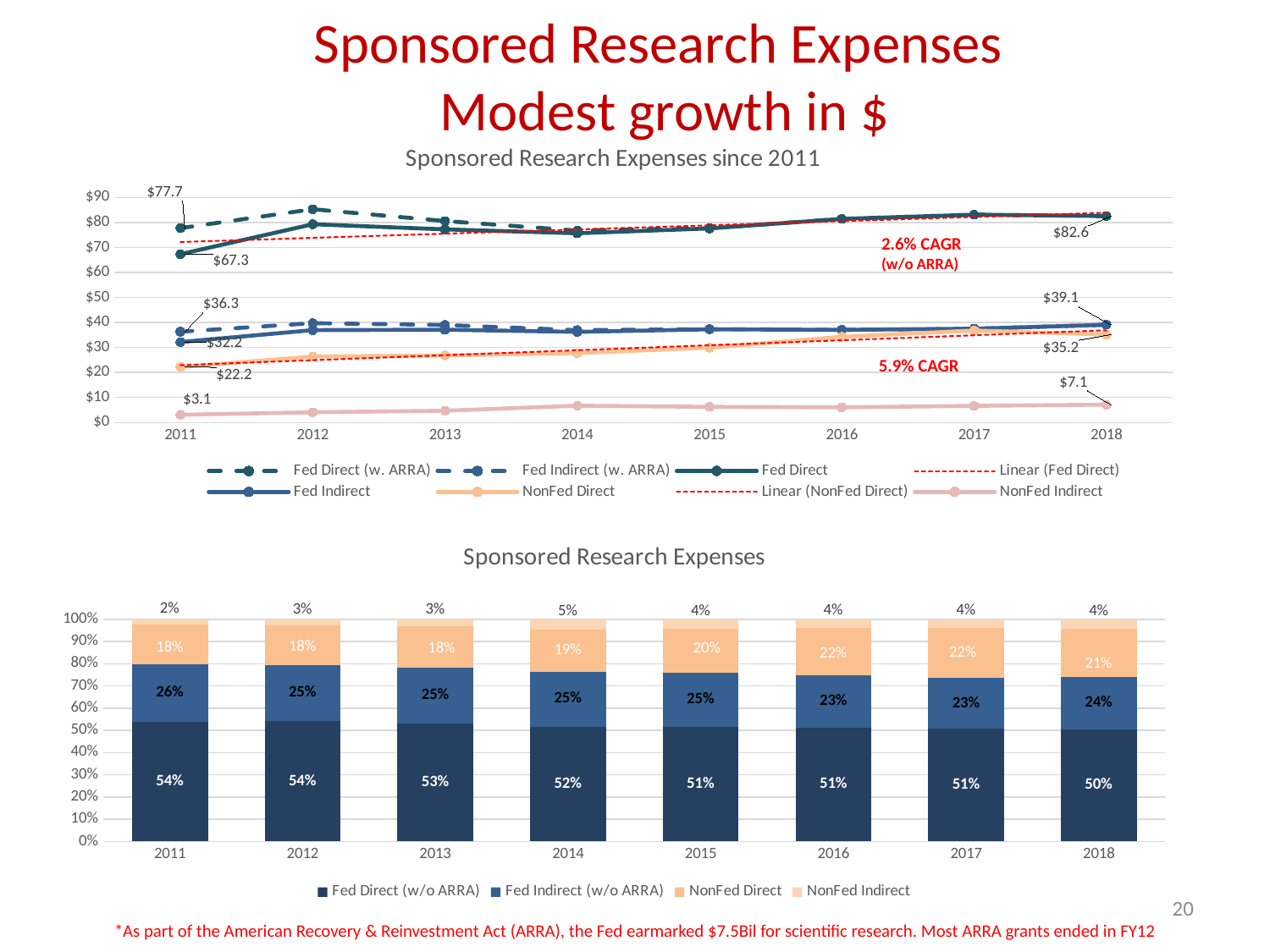
In the bottom chart, Sponsored Research Expenses, what share is Fed Direct (w/o ARRA) in 2018? 50% In the top chart, Sponsored Research Expenses since 2011, how many series does the legend list? 8 In the top chart, Sponsored Research Expenses since 2011, what is the value of NonFed Indirect in 2018? $7.1 In the top chart, Sponsored Research Expenses since 2011, does NonFed Direct rise or fall from 2011 to 2018? rise In the top chart, Sponsored Research Expenses since 2011, what CAGR is shown for NonFed Direct? 5.9% CAGR In the top chart, Sponsored Research Expenses since 2011, what is the value of Fed Direct in 2018? $82.6 In the bottom chart, Sponsored Research Expenses, what share is NonFed Indirect in 2014? 5% In the bottom chart, Sponsored Research Expenses, what kind of chart is it? stacked bar chart In the top chart, Sponsored Research Expenses since 2011, how much did Fed Direct grow from 2011 ($67.3) to 2018 ($82.6)? $15.3 In the bottom chart, Sponsored Research Expenses, which year has the highest NonFed Indirect share? 2014 In the bottom chart, Sponsored Research Expenses, how many years are shown on the x axis? 8 In the top chart, Sponsored Research Expenses since 2011, what is the value of NonFed Direct in 2011? $22.2